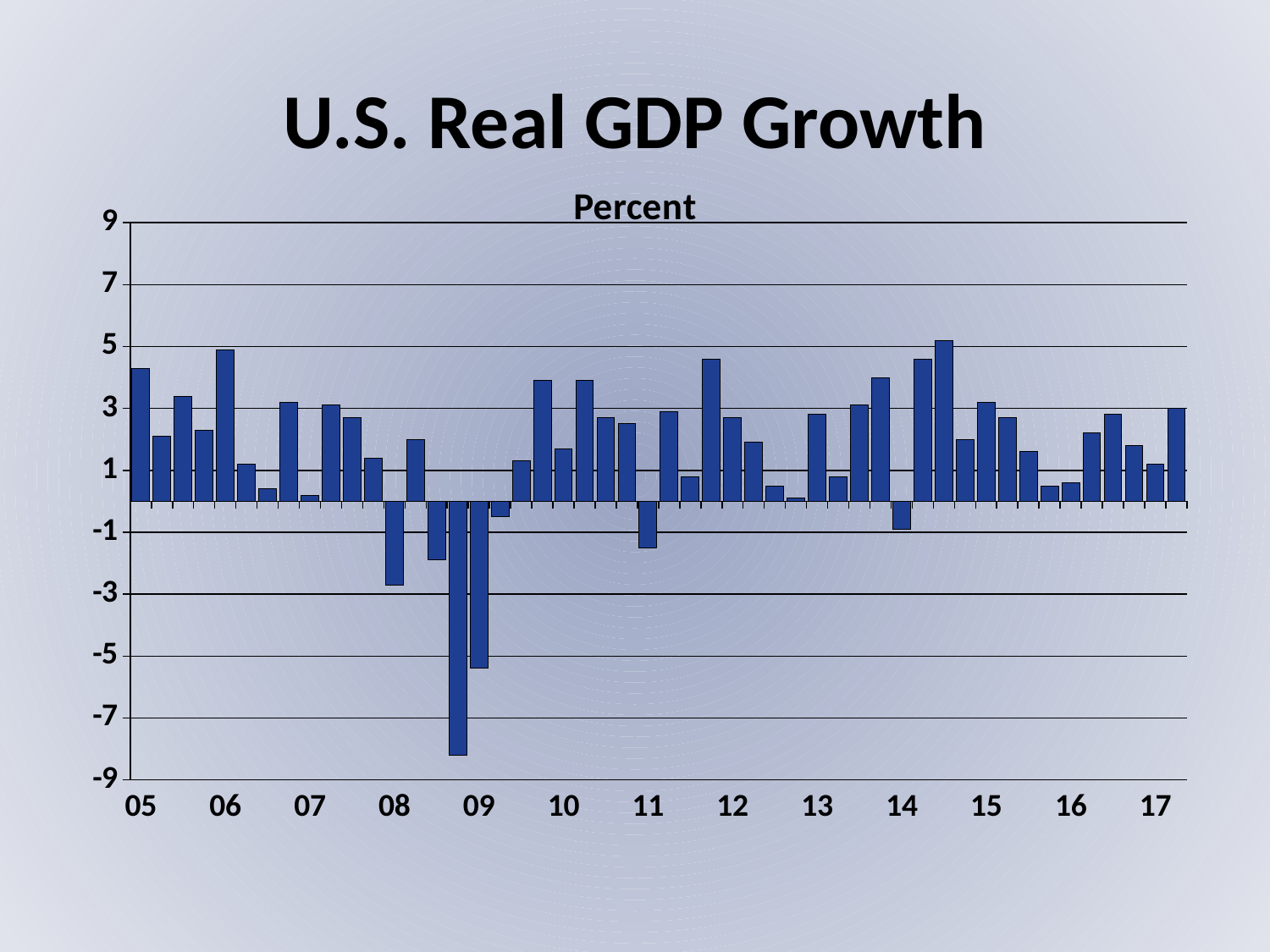
Is the tallest bar on the chart greater or less than 5? greater Is the first bar at the 05 label greater or less than 3? greater Is the bar at the 17 label greater or less than 1? greater What unit label is shown above the vertical axis? Percent What is the highest value shown on the vertical axis? 9 What kind of chart is shown on the slide? Bar chart What is the title of the chart? U.S. Real GDP Growth What is the lowest value shown on the vertical axis? -9 Which is larger, the first bar at the 05 label or the first bar at the 07 label? the first bar at 05 How many year labels appear along the x axis? 13